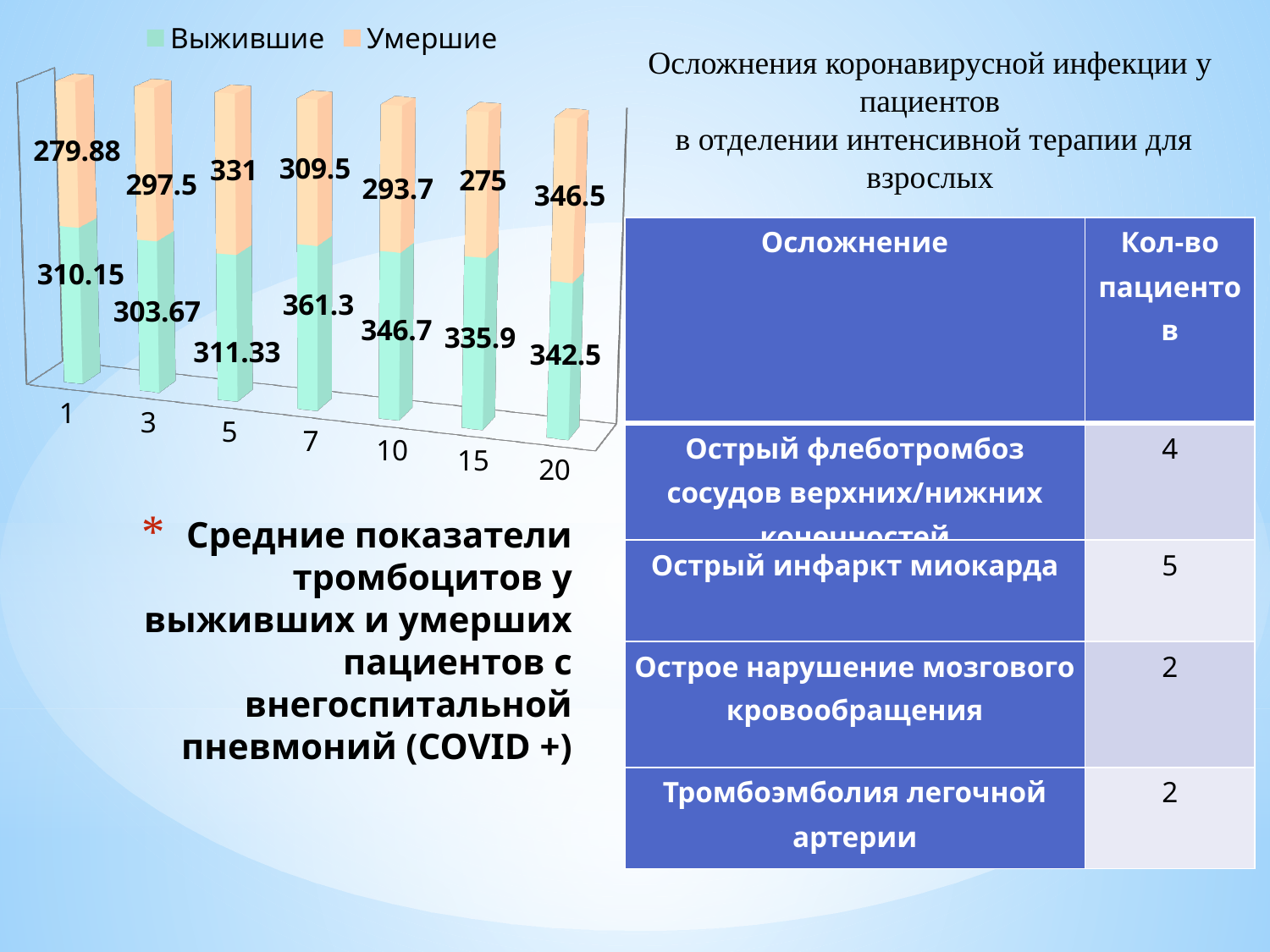
How many series does the chart legend list? 2 Which category has the highest value for Умершие? 20 How many categories are shown on the x axis of the chart? 7 At category 5, which is larger: Выжившие or Умершие? Умершие What is the value for Умершие at category 15? 275 What kind of chart is shown on the slide? Stacked bar chart Which category has the highest value for Выжившие? 7 What is the difference between Выжившие and Умершие at category 20? 4 What is the value for Выжившие at category 1? 310.15 Which category has the lowest value for Умершие? 15 What is the value for Выжившие at category 7? 361.3 What is the value for Умершие at category 5? 331